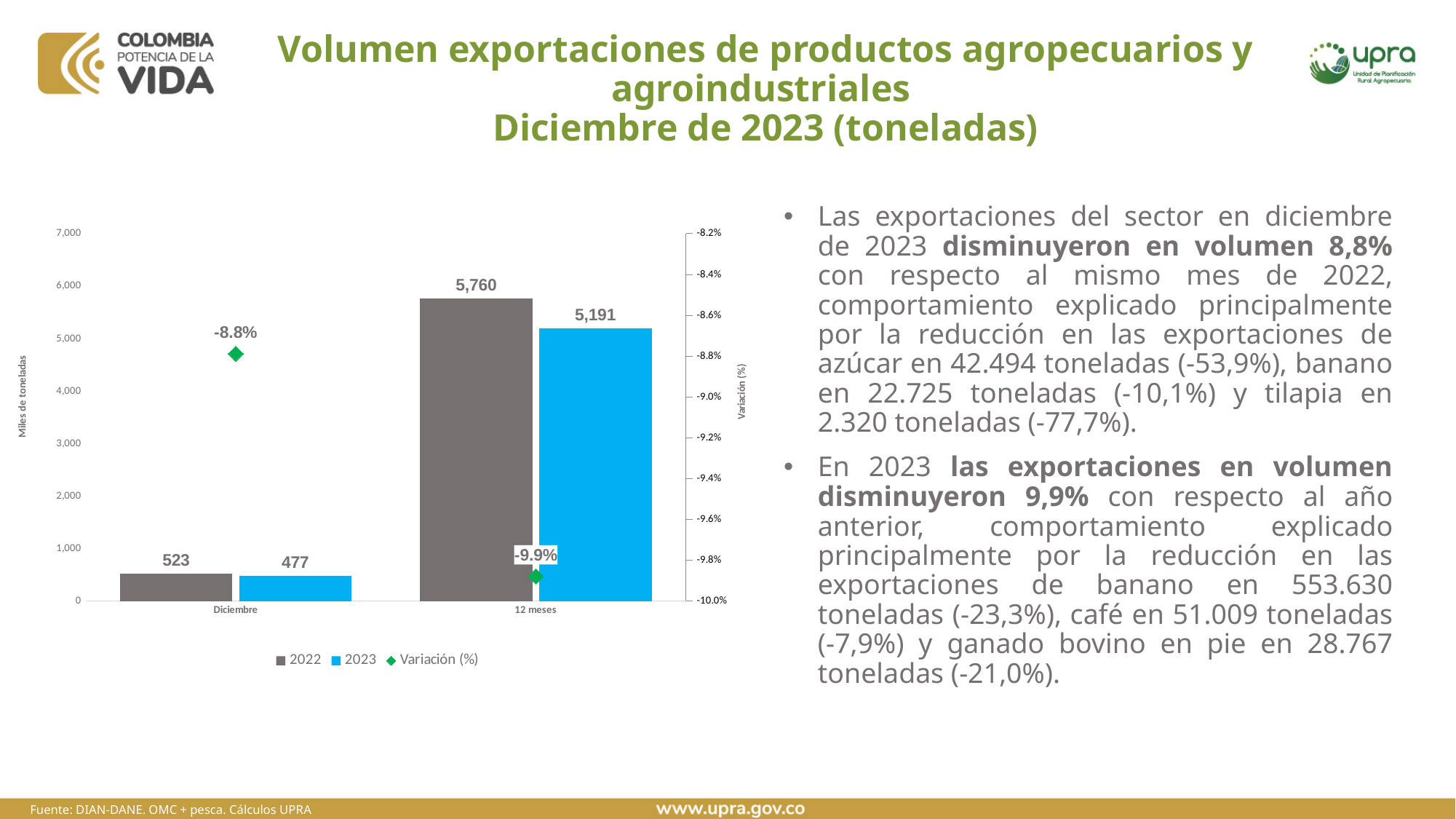
What is the Variación (%) value for 12 meses? -9.9% What is the 2022 value for Diciembre? 523 Which is larger for Diciembre, the 2022 value or the 2023 value? 2022 What is the 2022 value for 12 meses? 5,760 How many series does the legend list? 3 What is the difference between the 2022 and 2023 values for 12 meses? 569 What is the difference between the 2022 and 2023 values for Diciembre? 46 What is the 2023 value for 12 meses? 5,191 What is the label of the left vertical axis? Miles de toneladas How many categories are shown on the x axis? 2 What is the 2023 value for Diciembre? 477 What is the Variación (%) value for Diciembre? -8.8%